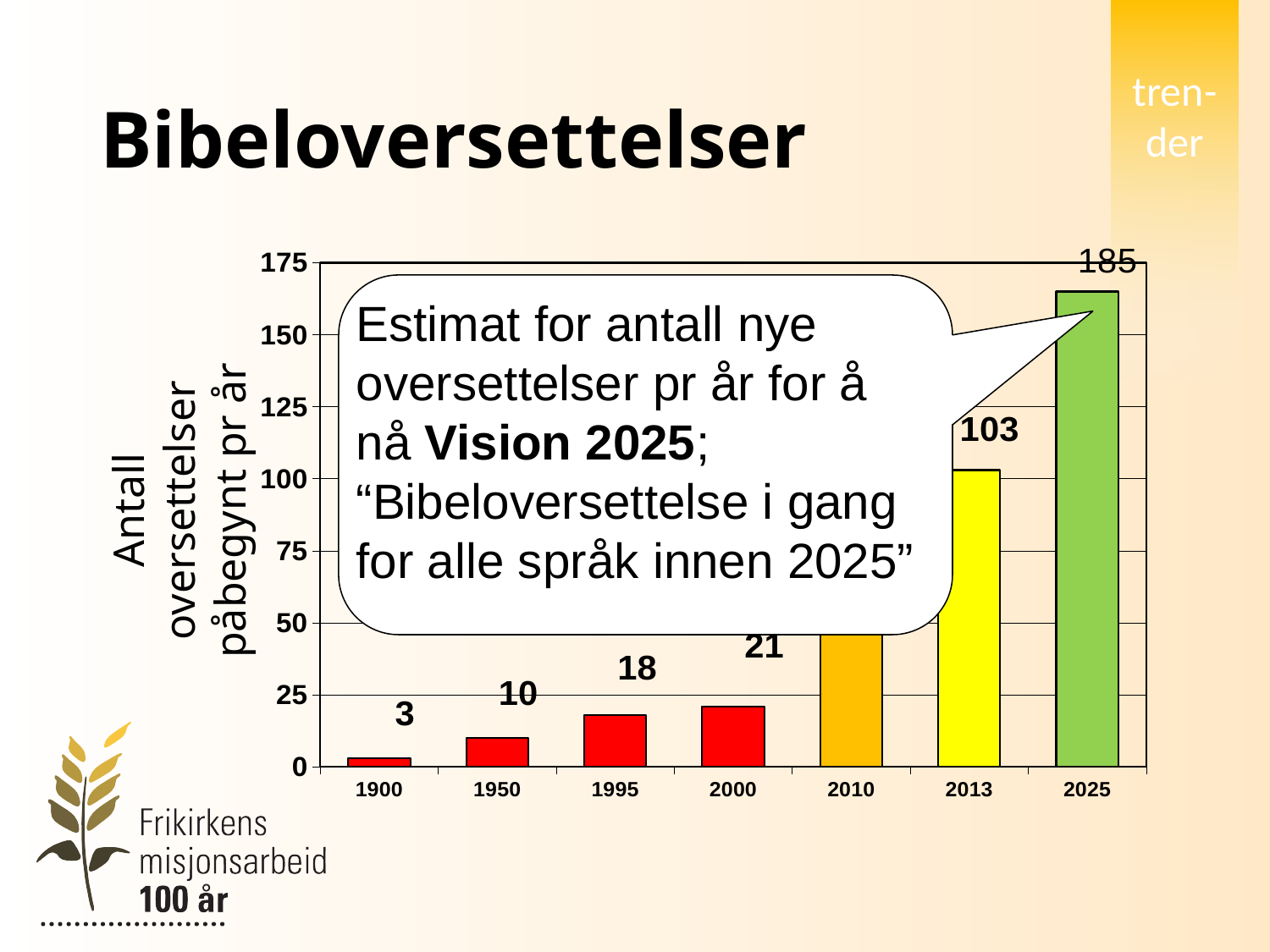
What is the value for 1900? 3 Which year has the highest value? 2025 Do the values rise or fall from 1900 to 2025? rise What is the value for 2000? 21 What is the value for 2013? 103 Is the value for 2010 greater or less than 25? greater What is the difference between the values for 2013 and 2000? 82 Which year has the lowest value? 1900 Which is larger, the value for 1950 or the value for 1995? 1995 How many years are shown on the x axis? 7 What value is labelled on the bar for 2025? 185 What is the value for 1950? 10